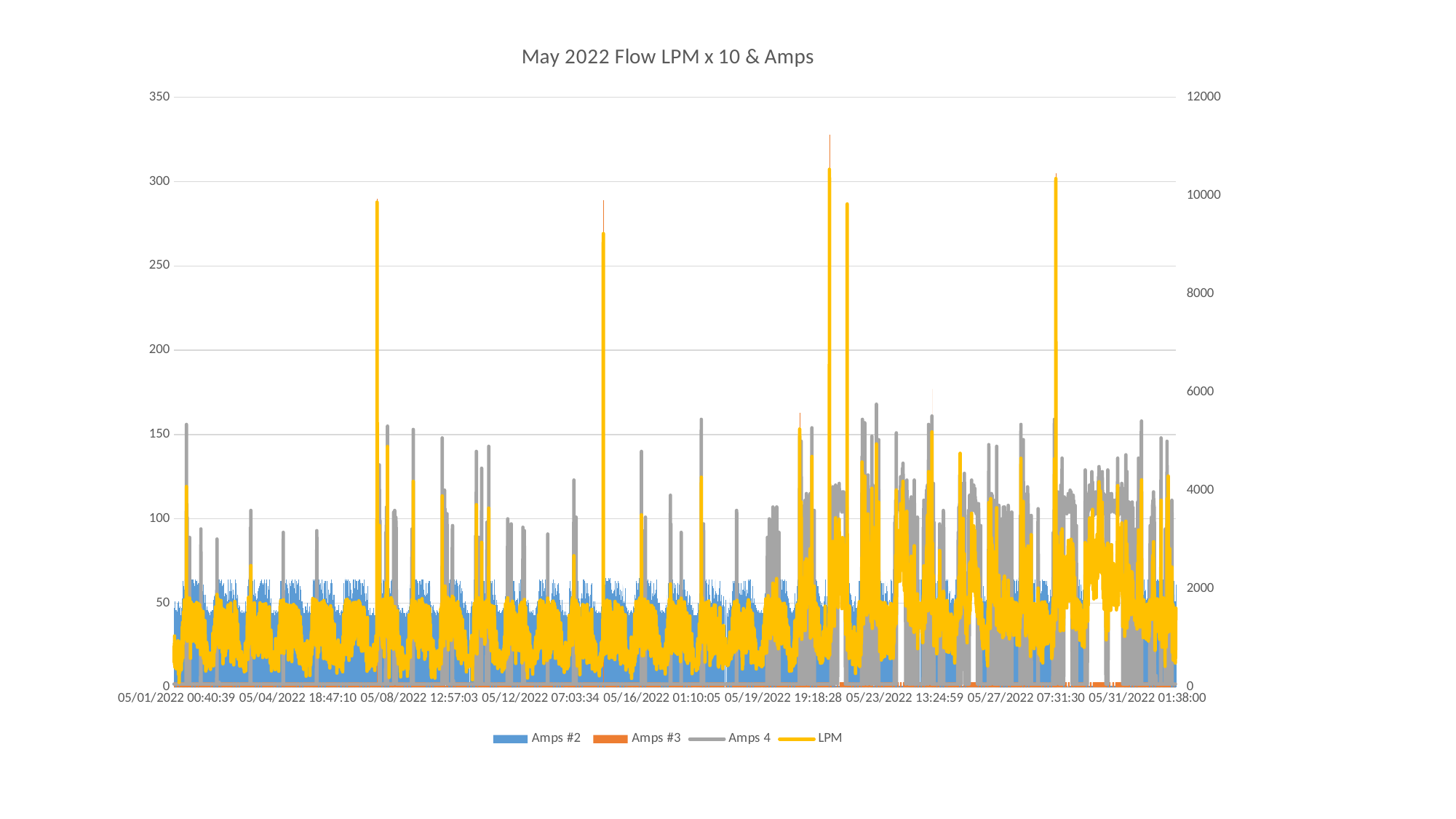
Which series is plotted in yellow? LPM How many series does the legend list? 4 Is the highest LPM peak on the chart greater or less than 12000 on the right-hand axis? less What is the title of the chart? May 2022 Flow LPM x 10 & Amps What kind of chart is shown on the slide? combination chart (bars and lines) Is the highest LPM peak on the chart greater or less than 10000 on the right-hand axis? greater